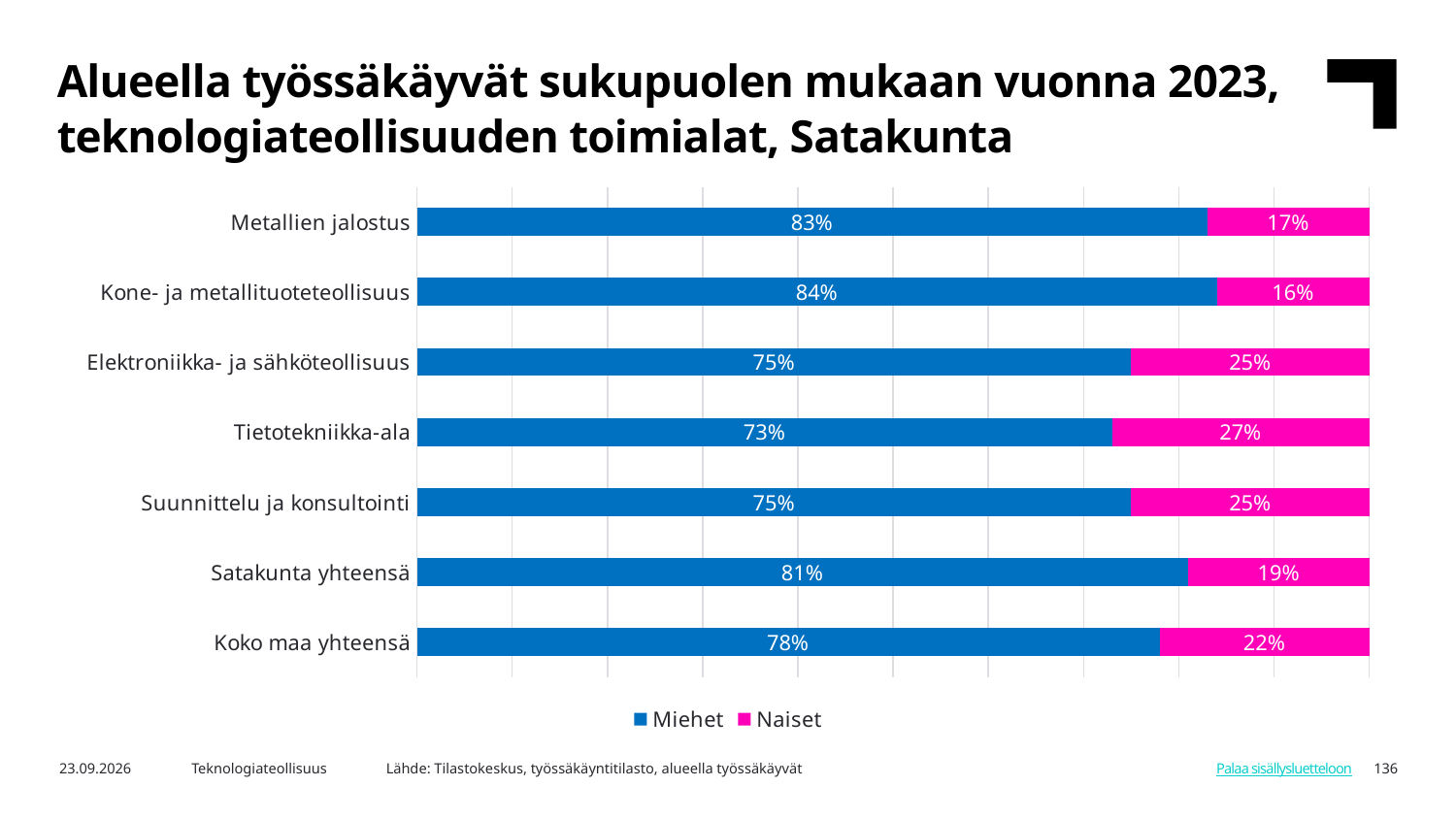
Which category has the highest Miehet share? Kone- ja metallituoteteollisuus How many series does the legend list? 2 Which category has the highest Naiset share? Tietotekniikka-ala Which category has the lowest Miehet share? Tietotekniikka-ala What is the Miehet share for Metallien jalostus? 83% What is the Naiset share for Koko maa yhteensä? 22% What is the Naiset share for Tietotekniikka-ala? 27% How many categories are shown on the chart? 7 What is the Miehet share for Satakunta yhteensä? 81% Which is larger, the Miehet share for Metallien jalostus or for Elektroniikka- ja sähköteollisuus? Metallien jalostus What is the difference in Naiset share between Koko maa yhteensä and Satakunta yhteensä? 3 percentage points What kind of chart is shown on the slide? Stacked bar chart